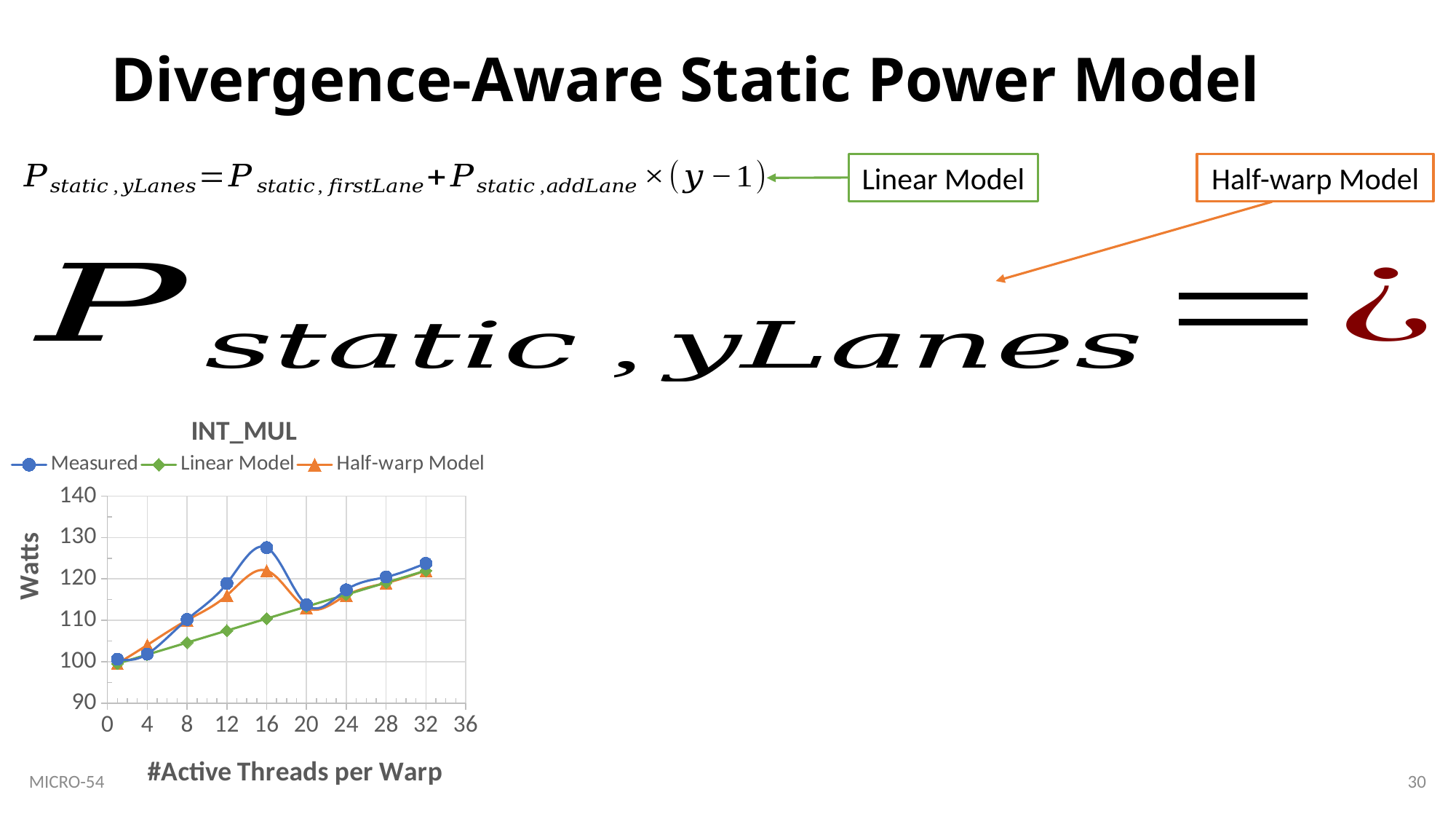
What is the label of the y axis of the chart? Watts How many data points are plotted for the Linear Model series? 9 What kind of chart is shown on the slide? line chart Is the Linear Model value at 16 active threads per warp greater or less than 120? less Does the Linear Model series rise or fall as the number of active threads per warp increases? rise At which number of active threads per warp does the Measured series reach its highest value? 16 How many series does the legend of the INT_MUL chart list? 3 What is the title of the chart on the slide? INT_MUL At 16 active threads per warp, which series has the larger value: Measured or Linear Model? Measured Is the Measured value at 32 active threads per warp greater or less than 120? greater Is the Linear Model value at 8 active threads per warp greater or less than 110? less